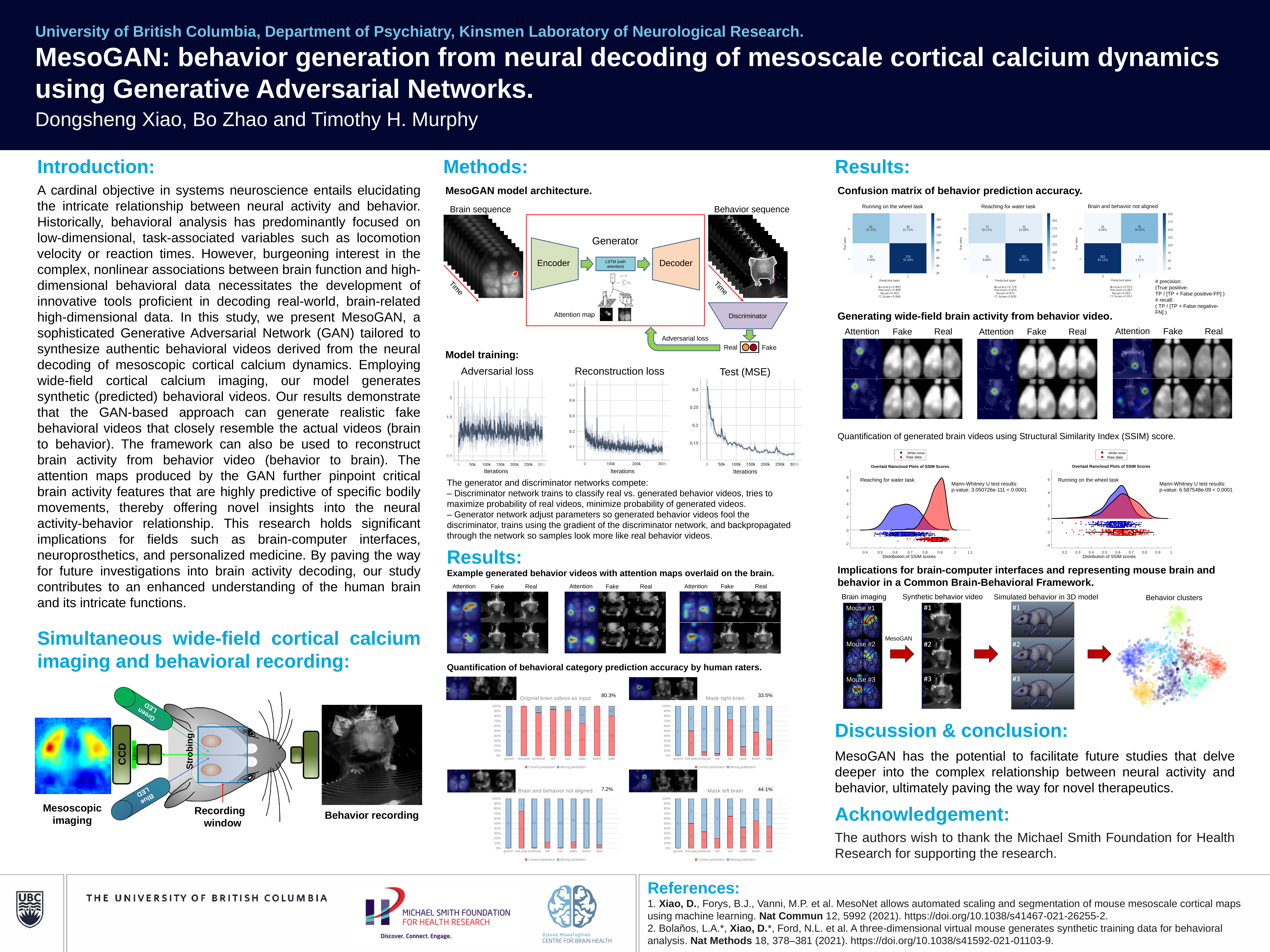
In the 'Quantification of behavioral category prediction accuracy by human raters' section, what kind of chart is used for each condition? Stacked bar chart Among the four human-rater conditions (Original brain videos as input, Mask right brain, Brain and behavior not aligned, Mask left brain), which has the lowest printed accuracy? Brain and behavior not aligned In the 'Quantification of behavioral category prediction accuracy by human raters' charts, how many series does the legend list? 2 What is the difference between the printed accuracy for 'Original brain videos as input' (80.3%) and 'Brain and behavior not aligned' (7.2%)? 73.1% In the 'Test (MSE)' chart under Model training, do the values rise or fall as iterations increase? Fall What overall accuracy percentage is printed for the 'Original brain videos as input' condition? 80.3% Among the four human-rater conditions, which has the highest printed accuracy? Original brain videos as input In the confusion matrix for the 'Running on the wheel task', what accuracy value is printed below the matrix? 0.803 Which has a higher printed accuracy: 'Mask left brain' or 'Mask right brain'? Mask left brain What overall accuracy percentage is printed for the 'Mask right brain' condition? 33.5% In the overlaid raincloud plots of SSIM scores, what two entries does the legend list? White noise, Raw data In the 'Original brain videos as input' bar chart, how many categories are shown on the x axis? 8